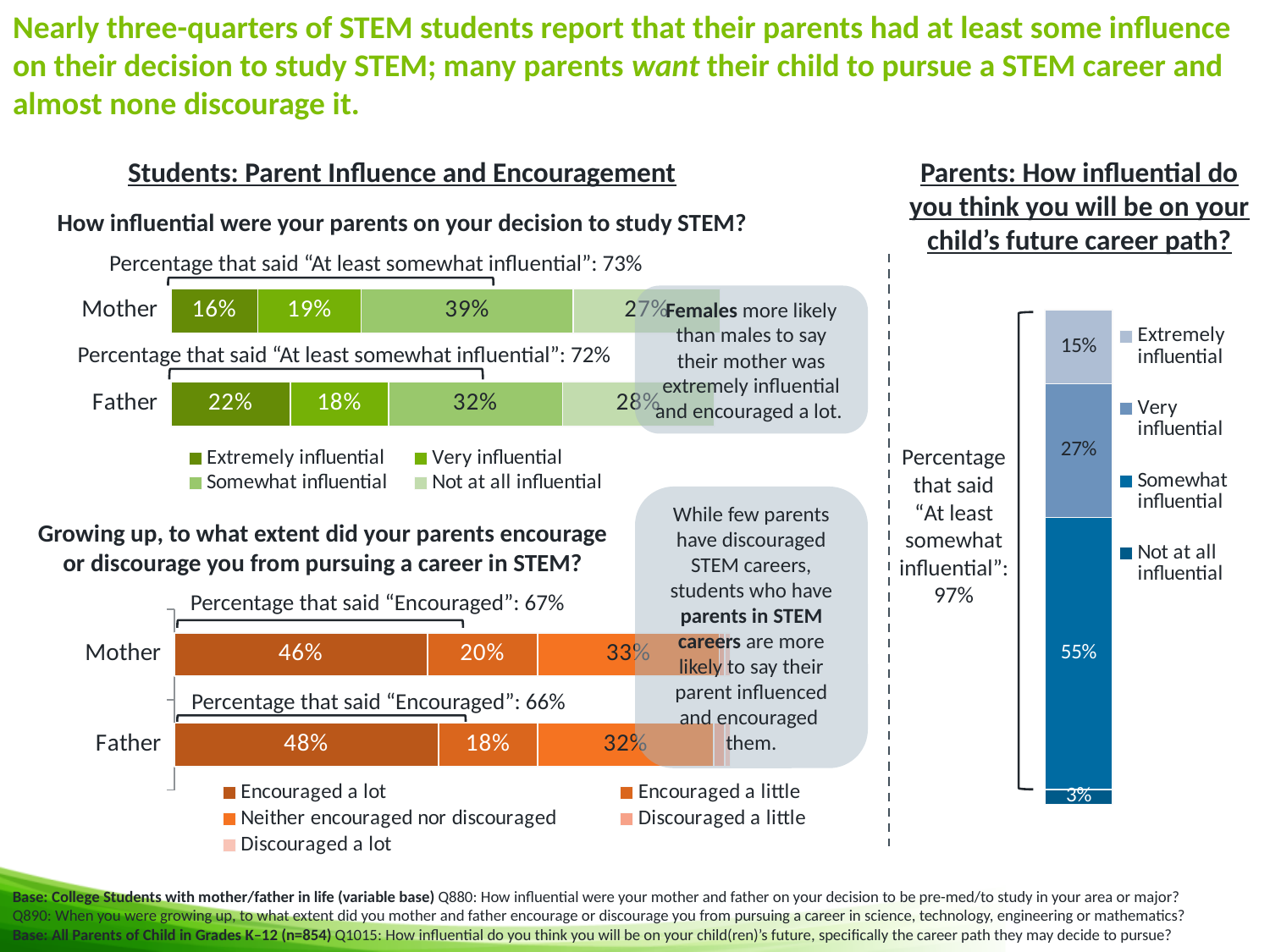
In the chart 'How influential were your parents on your decision to study STEM?', what is the difference between the 'Not at all influential' percentages for Father and Mother? 1% In the chart 'Growing up, to what extent did your parents encourage or discourage you from pursuing a career in STEM?', what percentage said their father neither encouraged nor discouraged them? 32% In the chart 'How influential were your parents on your decision to study STEM?', what percentage said their mother was extremely influential? 16% In the chart 'Growing up, to what extent did your parents encourage or discourage you from pursuing a career in STEM?', what is the difference between the 'Encouraged a little' percentages for Mother and Father? 2% How many series does the legend list for the chart 'Growing up, to what extent did your parents encourage or discourage you from pursuing a career in STEM?' 5 How many series does the legend list for the chart 'How influential were your parents on your decision to study STEM?' 4 In the chart 'Parents: How influential do you think you will be on your child's future career path?', what percentage of parents said 'Somewhat influential'? 55% In the chart 'How influential were your parents on your decision to study STEM?', what percentage said their father was somewhat influential? 32% In the chart 'How influential were your parents on your decision to study STEM?', which is larger: the share saying their father was extremely influential or the share saying their mother was extremely influential? Father In the chart 'Parents: How influential do you think you will be on your child's future career path?', which response category has the lowest percentage? Not at all influential What kind of chart is 'Parents: How influential do you think you will be on your child's future career path?' Stacked bar chart In the chart 'Growing up, to what extent did your parents encourage or discourage you from pursuing a career in STEM?', what percentage said their mother encouraged them a lot? 46%